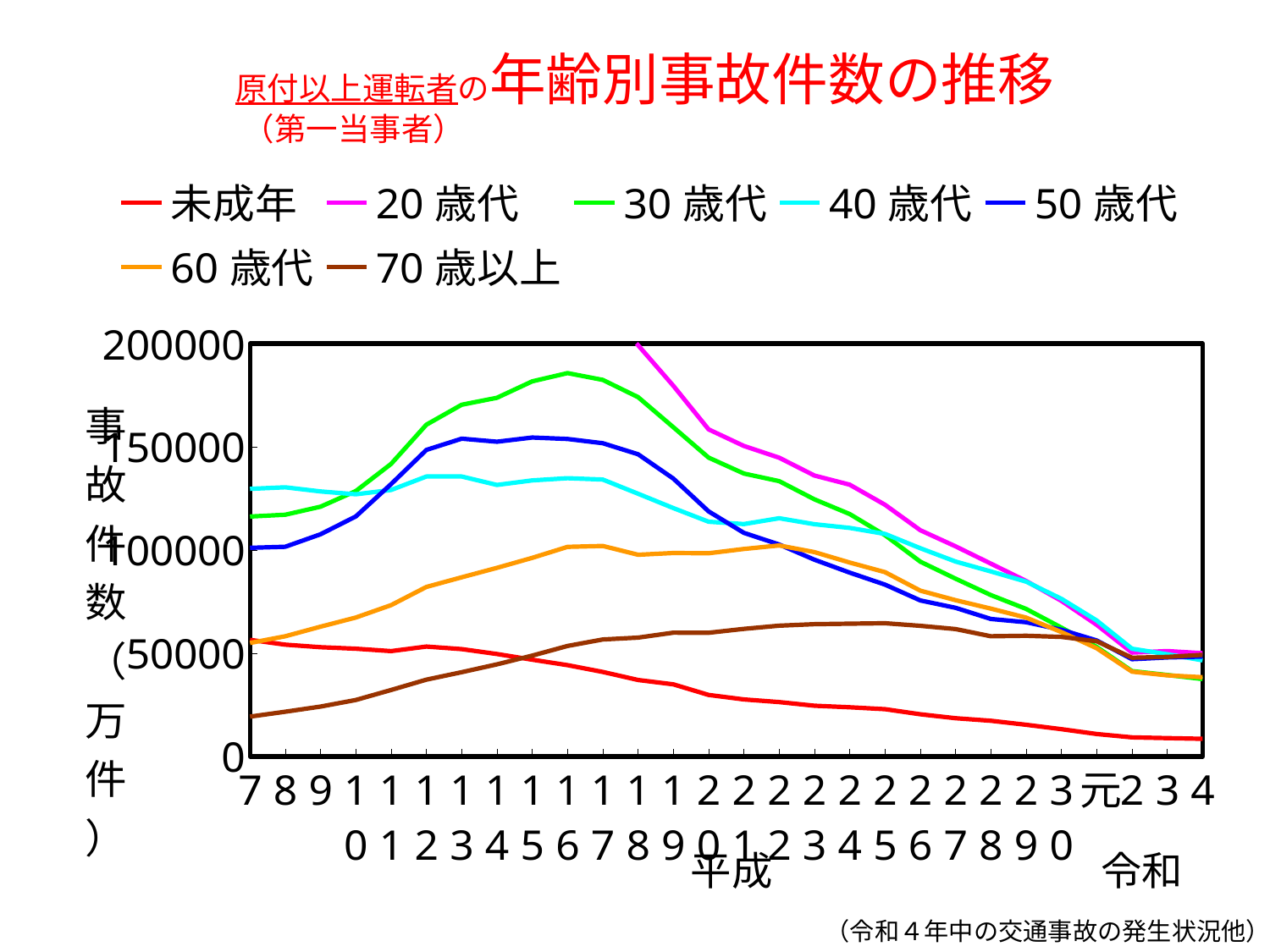
What kind of chart is shown on the slide? line chart Is the value for 70歳以上 in 平成7 greater or less than 50000? less Which series is listed first in the legend? 未成年 In 平成7, which is higher, 未成年 or 70歳以上? 未成年 How many series does the legend list? 7 What is the highest value shown on the y axis? 200000 Is the value for 30歳代 in 平成16 greater or less than 150000? greater Does the 70歳以上 line rise or fall from 平成7 to 平成20? rise Does the 未成年 line rise or fall from 平成7 to 令和4? fall Is the value for 未成年 in 令和4 greater or less than 50000? less Which series has the lowest value in 令和4? 未成年 In 平成7, which is higher, 40歳代 or 50歳代? 40歳代